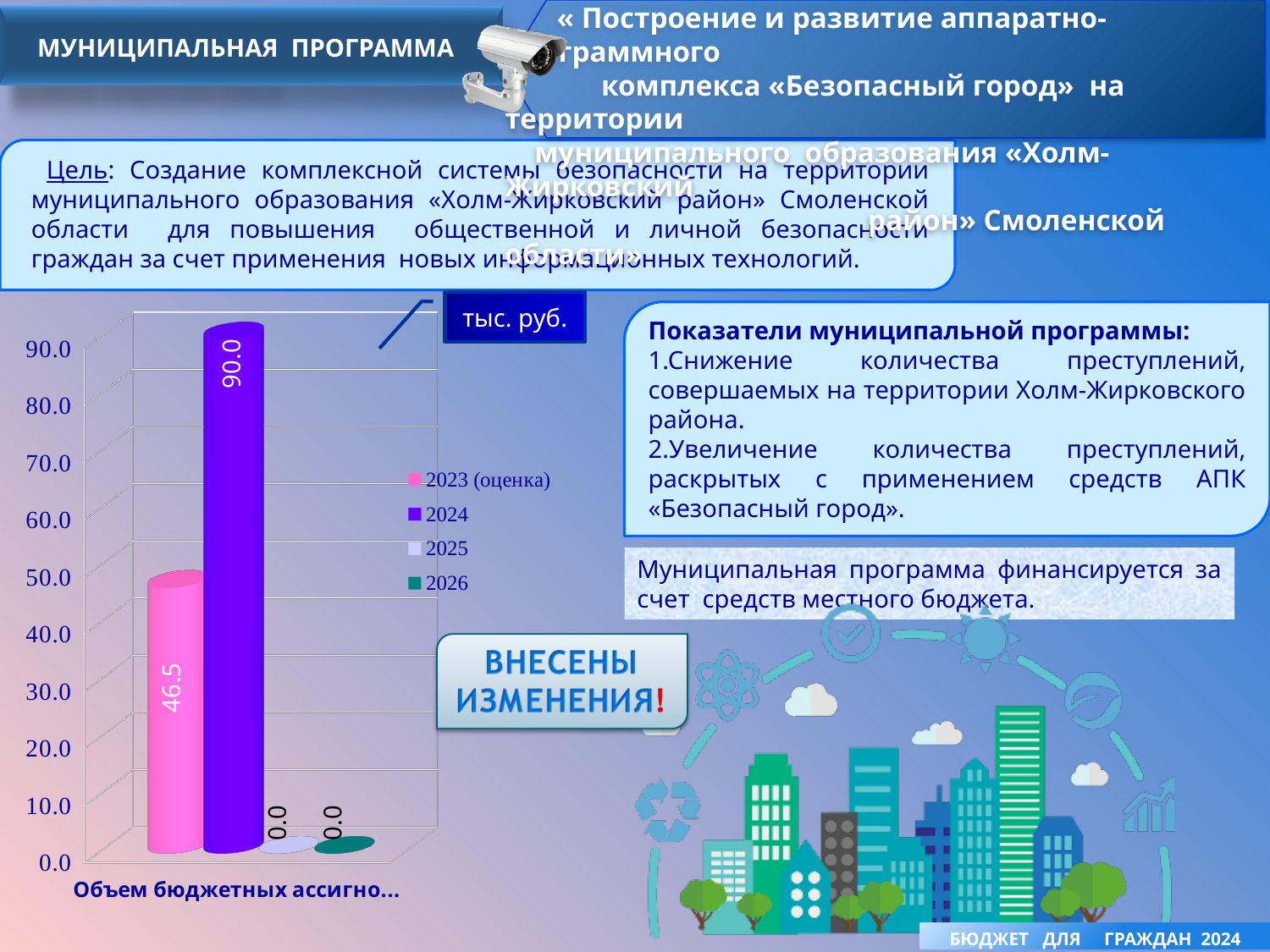
What colour is the bar for 2024 in the chart? purple What unit is shown in the box above the chart? тыс. руб. What is the value for 2026 on the chart? 0.0 Which is larger, the value for 2023 (оценка) or the value for 2024? 2024 Is the value for 2023 (оценка) greater or less than 50.0? less How many series does the chart legend list? 4 What is the value for 2023 (оценка) on the chart? 46.5 What is the value for 2024 on the chart? 90.0 What is the value for 2025 on the chart? 0.0 What is the difference between the values for 2024 and 2023 (оценка)? 43.5 Which year has the highest value on the chart? 2024 What kind of chart is shown on the slide? bar chart